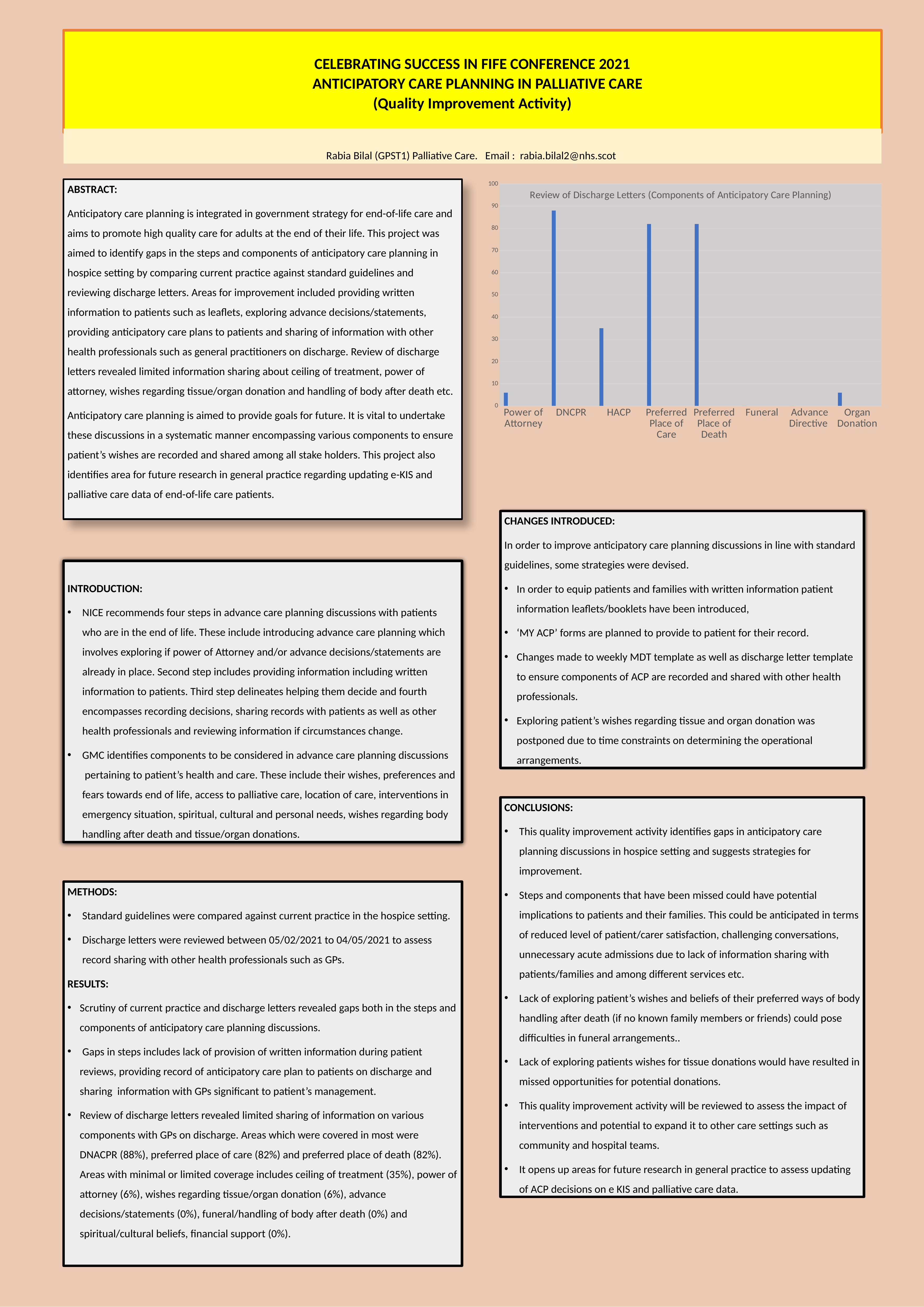
What kind of chart is shown on the slide? bar chart Which is larger, the value for HACP or the value for Organ Donation? HACP Is the value for DNCPR greater or less than 80? greater Is the value for HACP greater or less than 30? greater Which category has the highest bar in the chart? DNCPR What is the title of the chart? Review of Discharge Letters (Components of Anticipatory Care Planning) Is the value for Preferred Place of Care greater or less than 80? greater Which is larger, the value for DNCPR or the value for HACP? DNCPR What colour are the bars in the chart? blue How many categories are shown on the x axis of the chart? 8